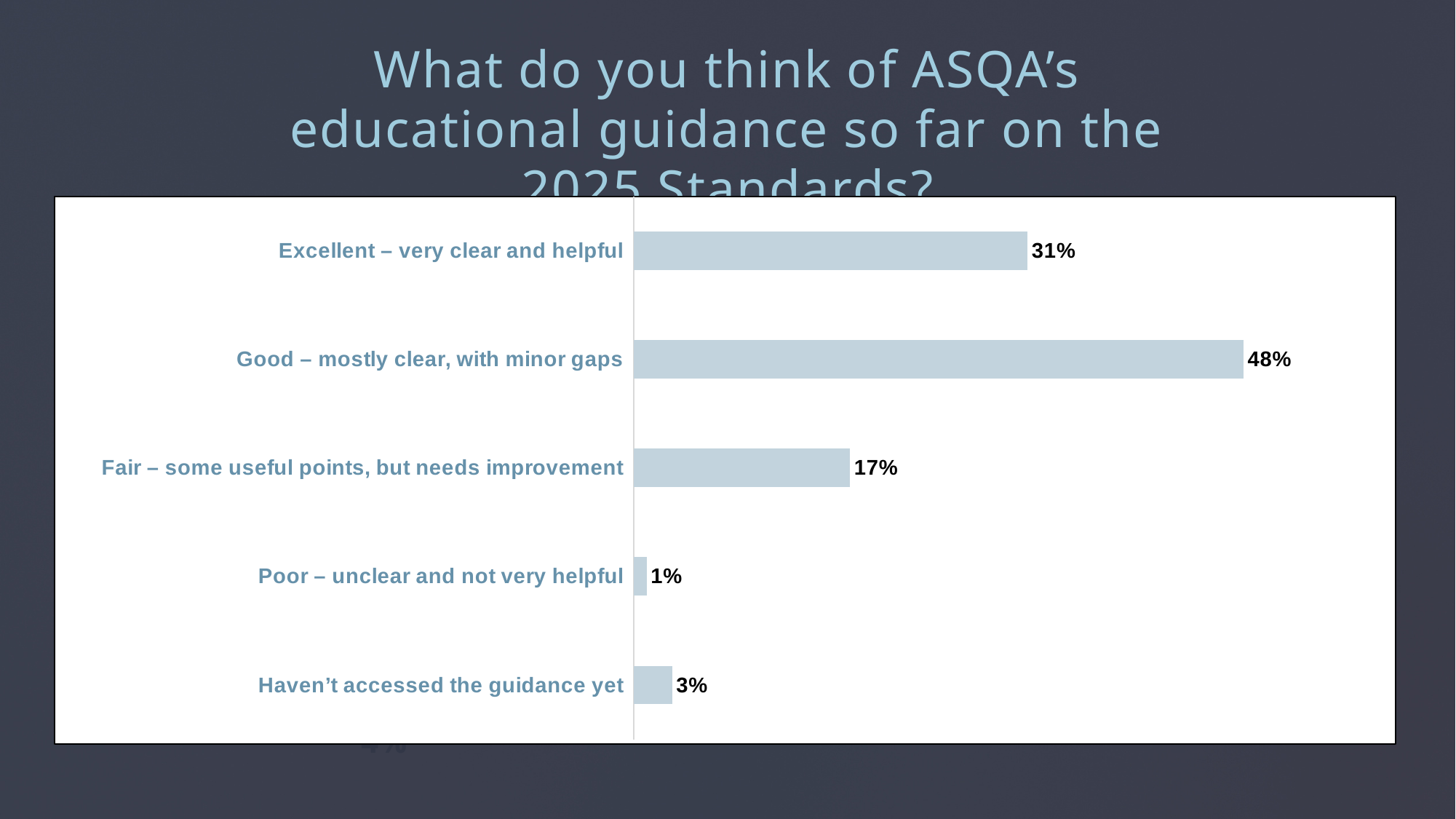
What is the difference between the 'Fair' and 'Poor' percentages? 16% What is the difference between the 'Good' and 'Excellent' percentages? 17% What kind of chart is shown on the slide? Bar chart How many response categories are shown in the chart? 5 Which is larger, the value for 'Excellent – very clear and helpful' or 'Fair – some useful points, but needs improvement'? Excellent – very clear and helpful Which response category has the highest value? Good – mostly clear, with minor gaps What percentage of respondents said they haven't accessed the guidance yet? 3% What percentage of respondents rated ASQA's educational guidance as 'Excellent – very clear and helpful'? 31% What is the value for 'Good – mostly clear, with minor gaps'? 48% Which response category has the lowest value? Poor – unclear and not very helpful What is the value for 'Fair – some useful points, but needs improvement'? 17% What is the combined percentage of 'Excellent' and 'Good' responses? 79%